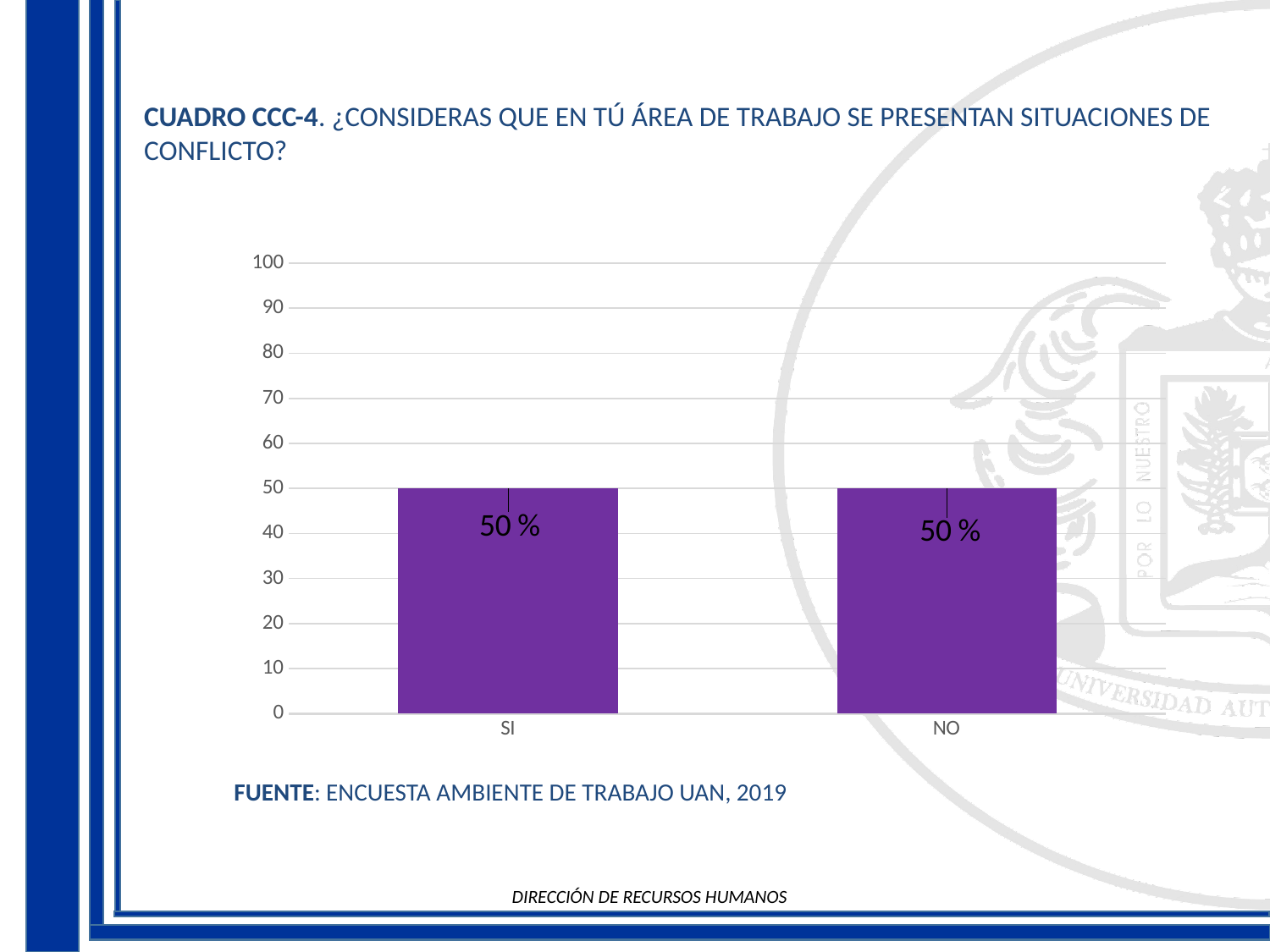
What is the difference between the values for SI and NO? 0 Is the value for SI greater or less than 60? less What is the highest value shown on the y axis? 100 What colour are the bars in the chart? purple How many categories are shown on the x axis? 2 What kind of chart is shown on the slide? bar chart What is the total of the values for SI and NO? 100 % What is the value for SI? 50 % Do the values for SI and NO differ? No, both are 50 % What is the value for NO? 50 % Is the value for NO greater or less than 40? greater